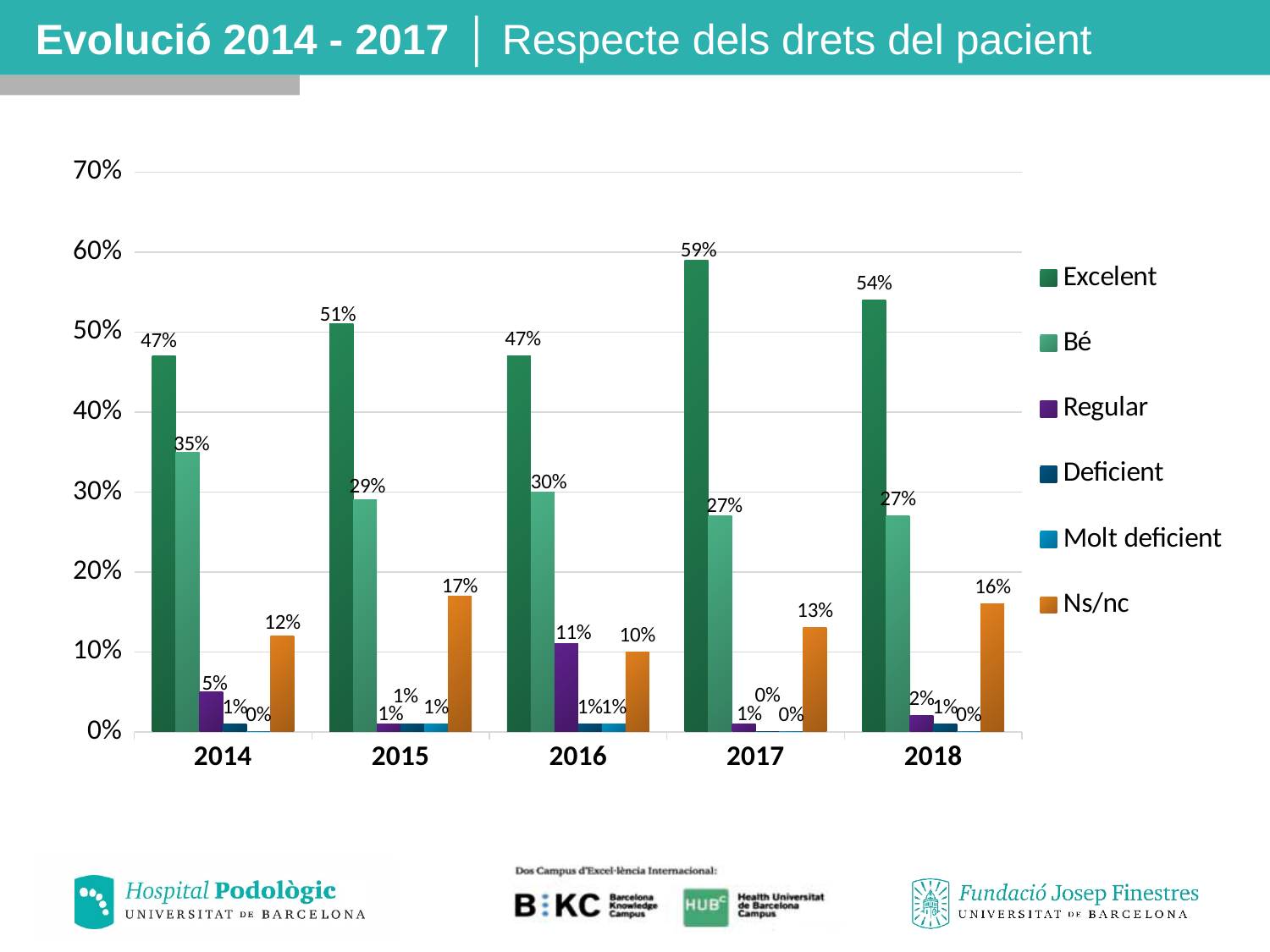
What is the value for Regular in 2016? 11% What is the value for Excelent in 2017? 59% What is the value for Ns/nc in 2015? 17% Which is larger, the Bé value in 2015 or the Bé value in 2016? 2016 In which year is the Ns/nc value lowest? 2016 How many years are shown on the x axis? 5 Which series is shown in orange in the legend? Ns/nc In which year is the Excelent value highest? 2017 What is the value for Bé in 2014? 35% What is the difference between the Excelent values in 2018 and 2014? 7% What kind of chart is shown on the slide? Bar chart How many series does the legend list? 6